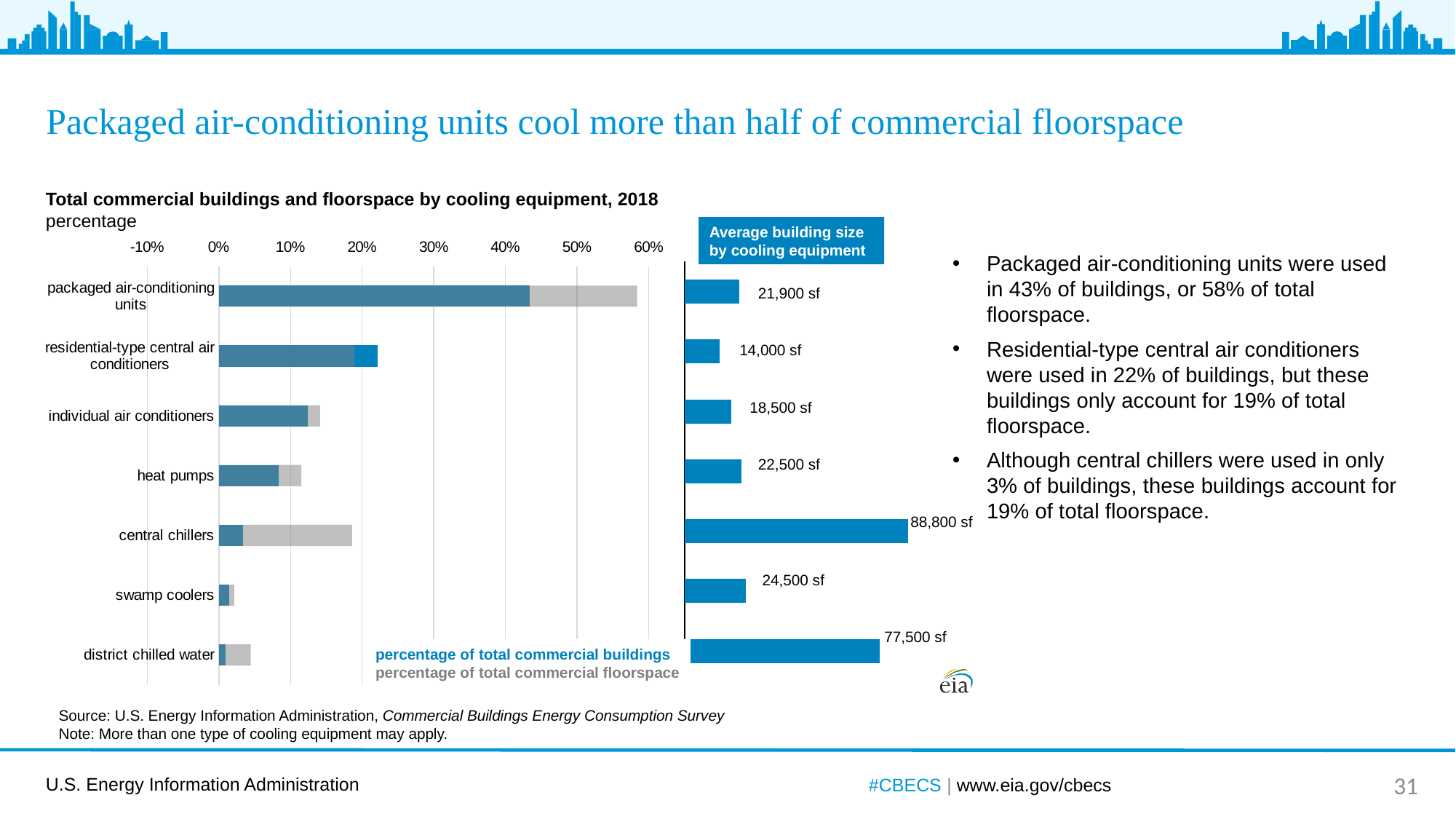
What kind of chart is the 'Average building size by cooling equipment' chart? bar chart In the 'Average building size by cooling equipment' chart, which cooling equipment has the smallest average building size? residential-type central air conditioners In the 'Average building size by cooling equipment' chart, what is the average building size for residential-type central air conditioners? 14,000 sf How many cooling equipment categories are shown in the 'Total commercial buildings and floorspace by cooling equipment, 2018' chart? 7 In the 'Average building size by cooling equipment' chart, what is the average building size for swamp coolers? 24,500 sf In the 'Average building size by cooling equipment' chart, which cooling equipment has the largest average building size? central chillers In the 'Total commercial buildings and floorspace by cooling equipment, 2018' chart, is the percentage of total commercial buildings for heat pumps greater or less than 10%? less How many series does the legend of the 'Total commercial buildings and floorspace by cooling equipment, 2018' chart list? 2 In the 'Total commercial buildings and floorspace by cooling equipment, 2018' chart, is the percentage of total commercial floorspace for packaged air-conditioning units greater or less than 50%? greater In the 'Average building size by cooling equipment' chart, what is the average building size for central chillers? 88,800 sf In the 'Average building size by cooling equipment' chart, which has a larger average building size, heat pumps or swamp coolers? swamp coolers In the 'Average building size by cooling equipment' chart, what is the difference in average building size between central chillers and district chilled water? 11,300 sf